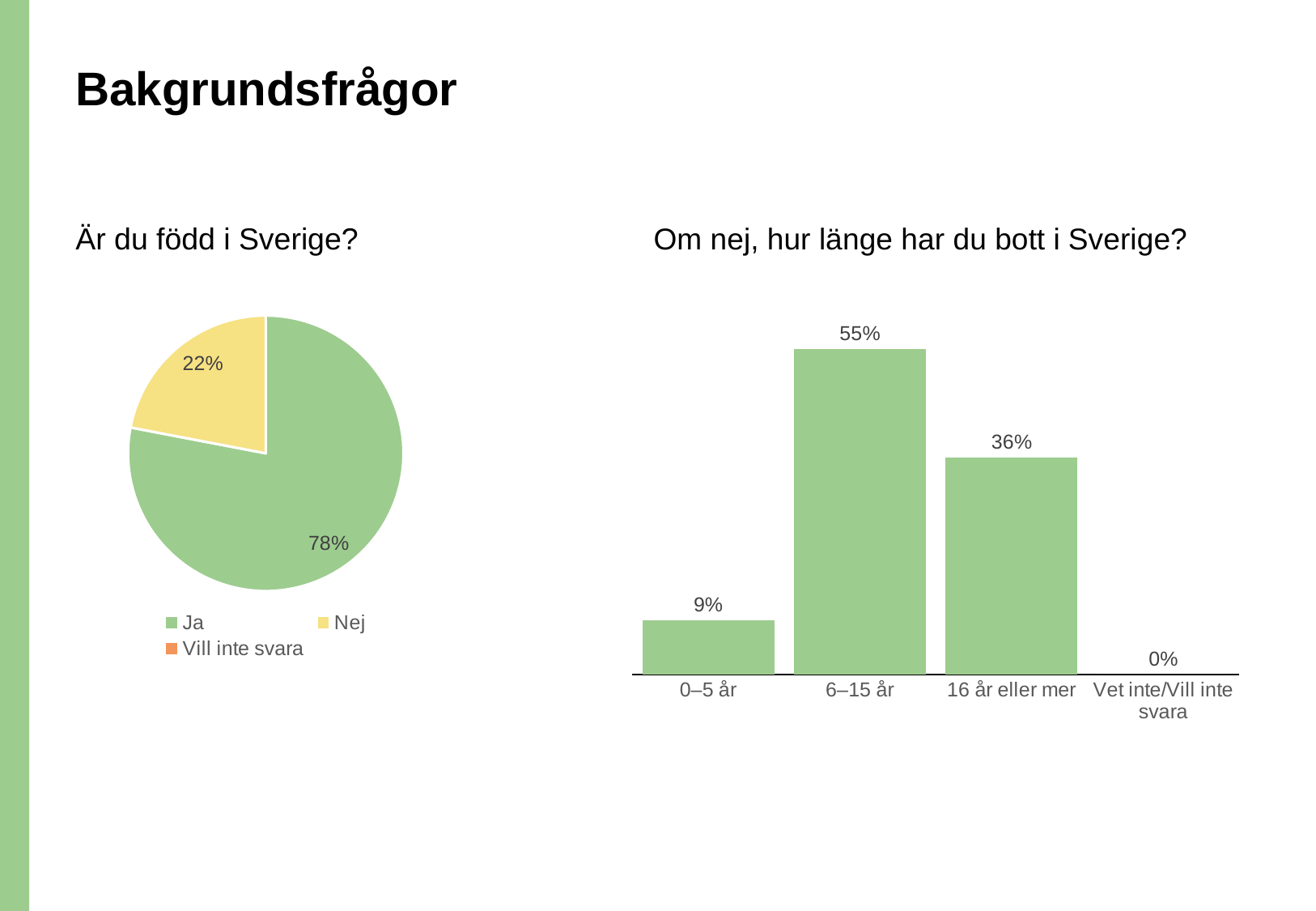
In the chart 'Om nej, hur länge har du bott i Sverige?', how many categories are shown on the x axis? 4 In the chart 'Om nej, hur länge har du bott i Sverige?', what is the value for '6–15 år'? 55% In the chart 'Om nej, hur länge har du bott i Sverige?', which category has the lowest value? Vet inte/Vill inte svara In the chart 'Om nej, hur länge har du bott i Sverige?', which category has the highest value? 6–15 år What kind of chart is the chart 'Om nej, hur länge har du bott i Sverige?'? Bar chart In the chart 'Är du född i Sverige?', what share of respondents answered 'Ja'? 78% In the chart 'Är du född i Sverige?', what share of respondents answered 'Nej'? 22% How many entries does the legend of the chart 'Är du född i Sverige?' list? 3 In the chart 'Är du född i Sverige?', what is the difference between the 'Ja' and 'Nej' shares? 56% In the chart 'Om nej, hur länge har du bott i Sverige?', what is the value for '0–5 år'? 9% In the chart 'Om nej, hur länge har du bott i Sverige?', what is the difference between '6–15 år' and '16 år eller mer'? 19% What kind of chart is the chart 'Är du född i Sverige?'? Pie chart